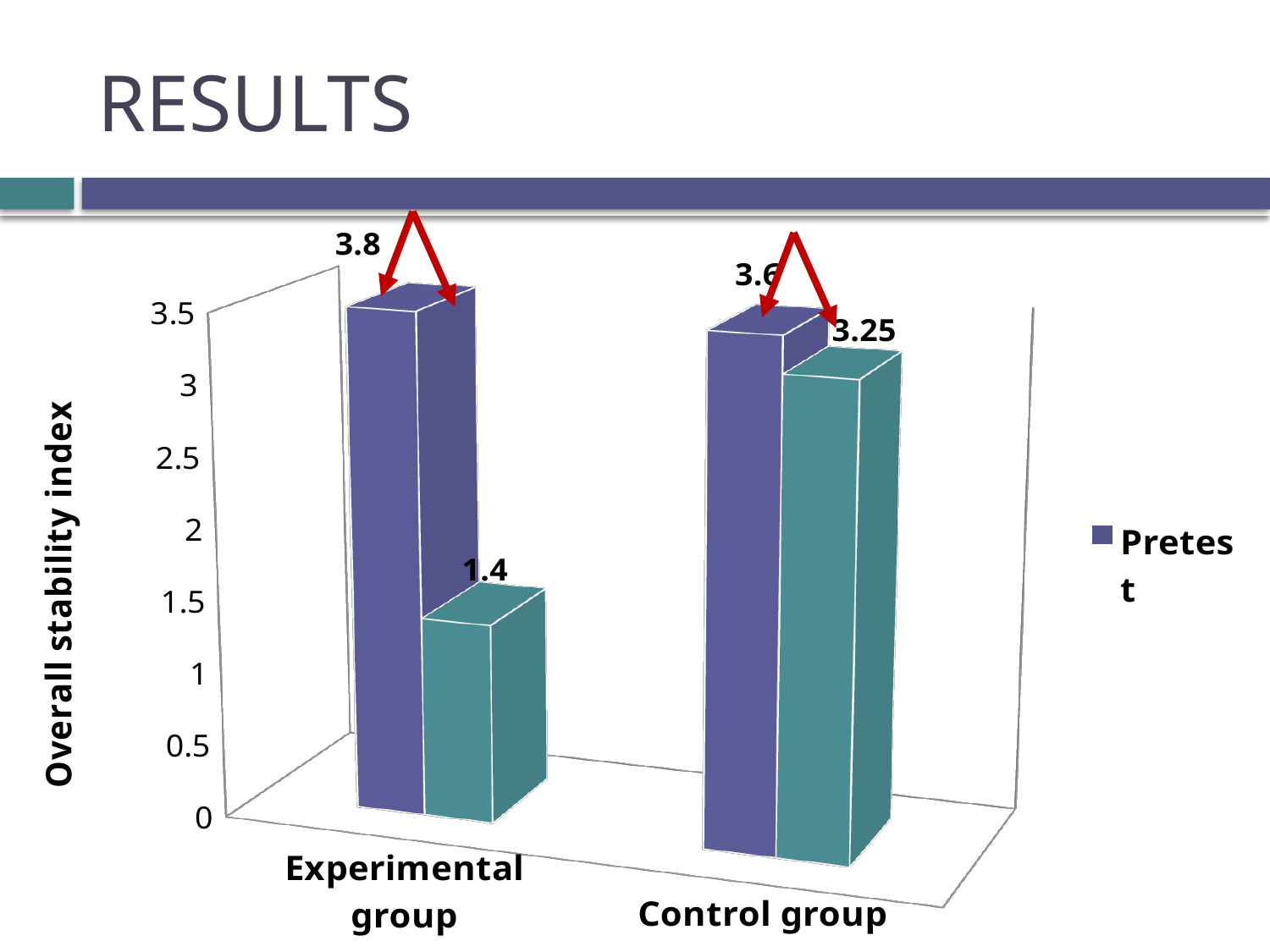
What is the value of the teal bar for the Experimental group? 1.4 What is the label of the vertical axis of the chart? Overall stability index Which bar has the lowest value on the chart? The teal bar for the Experimental group (1.4) What is the Pretest value for the Experimental group? 3.8 What type of chart is shown on the slide? Bar chart What is the Pretest value for the Control group? 3.6 What is the value of the teal bar for the Control group? 3.25 How many groups are shown on the x axis of the chart? 2 What is the difference between the Pretest value and the teal bar value for the Control group? 0.35 Is the teal bar for the Control group greater or less than 3? greater What is the difference between the Pretest value and the teal bar value for the Experimental group? 2.4 Which group has the higher Pretest value? Experimental group